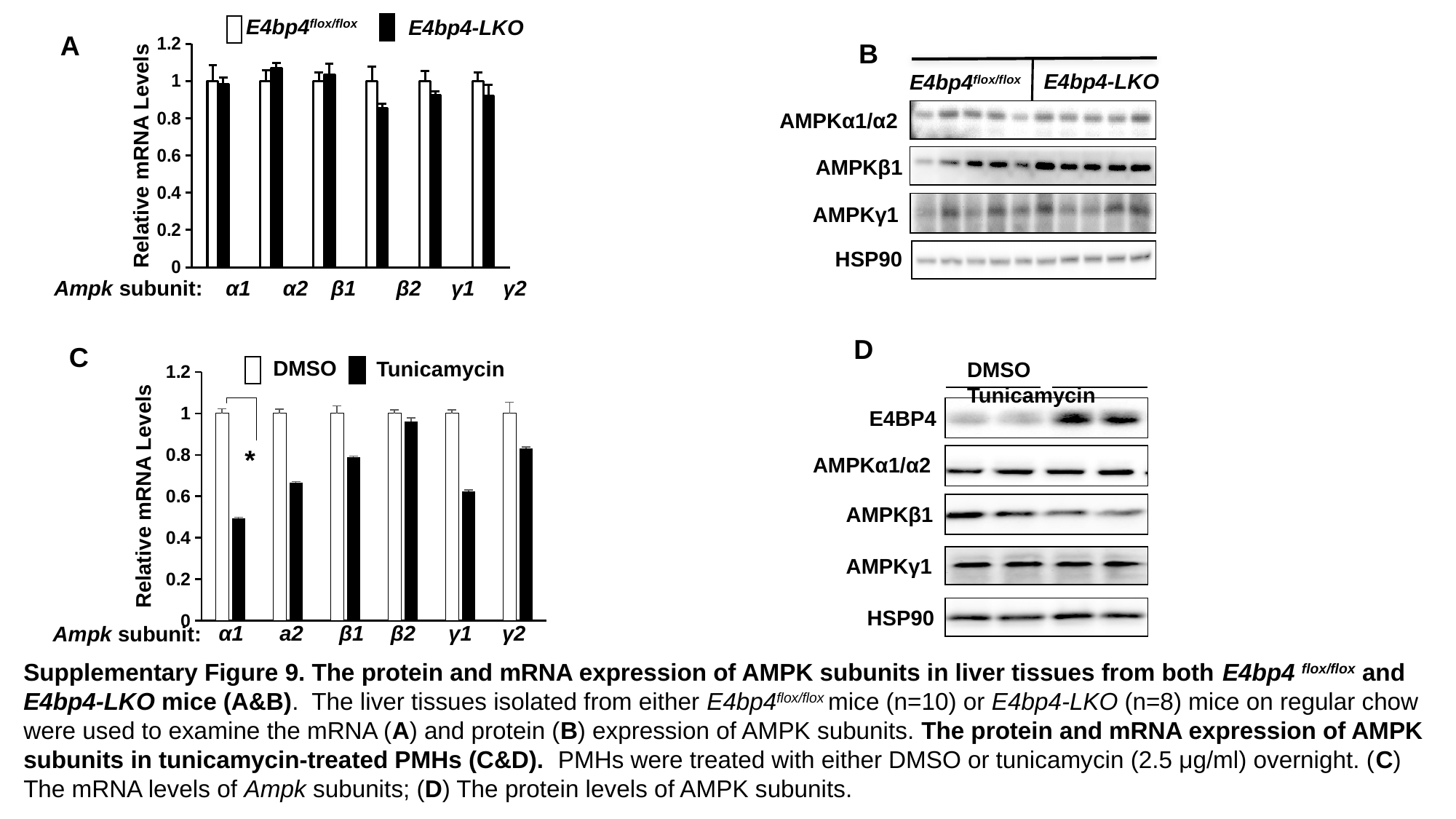
In panel C, which Ampk subunit has the highest Tunicamycin value? β2 In panel A, is the E4bp4-LKO value for β2 greater or less than 1? less In panel C, is the Tunicamycin value for α1 greater or less than 0.6? less In panel A, which is larger for E4bp4-LKO: the value for α2 or the value for β2? α2 In panel A, how many Ampk subunit categories are shown on the x axis? 6 In panel A, what is the y-axis title? Relative mRNA Levels In panel C, is the Tunicamycin value for γ2 greater or less than 0.6? greater In panel C, which Ampk subunit has the lowest Tunicamycin value? α1 In panel C, what are the two legend entries? DMSO and Tunicamycin What kind of chart is panel A? bar chart In panel A, how many series does the legend list? 2 In panel C, which is larger for Tunicamycin: the value for β1 or the value for γ1? β1